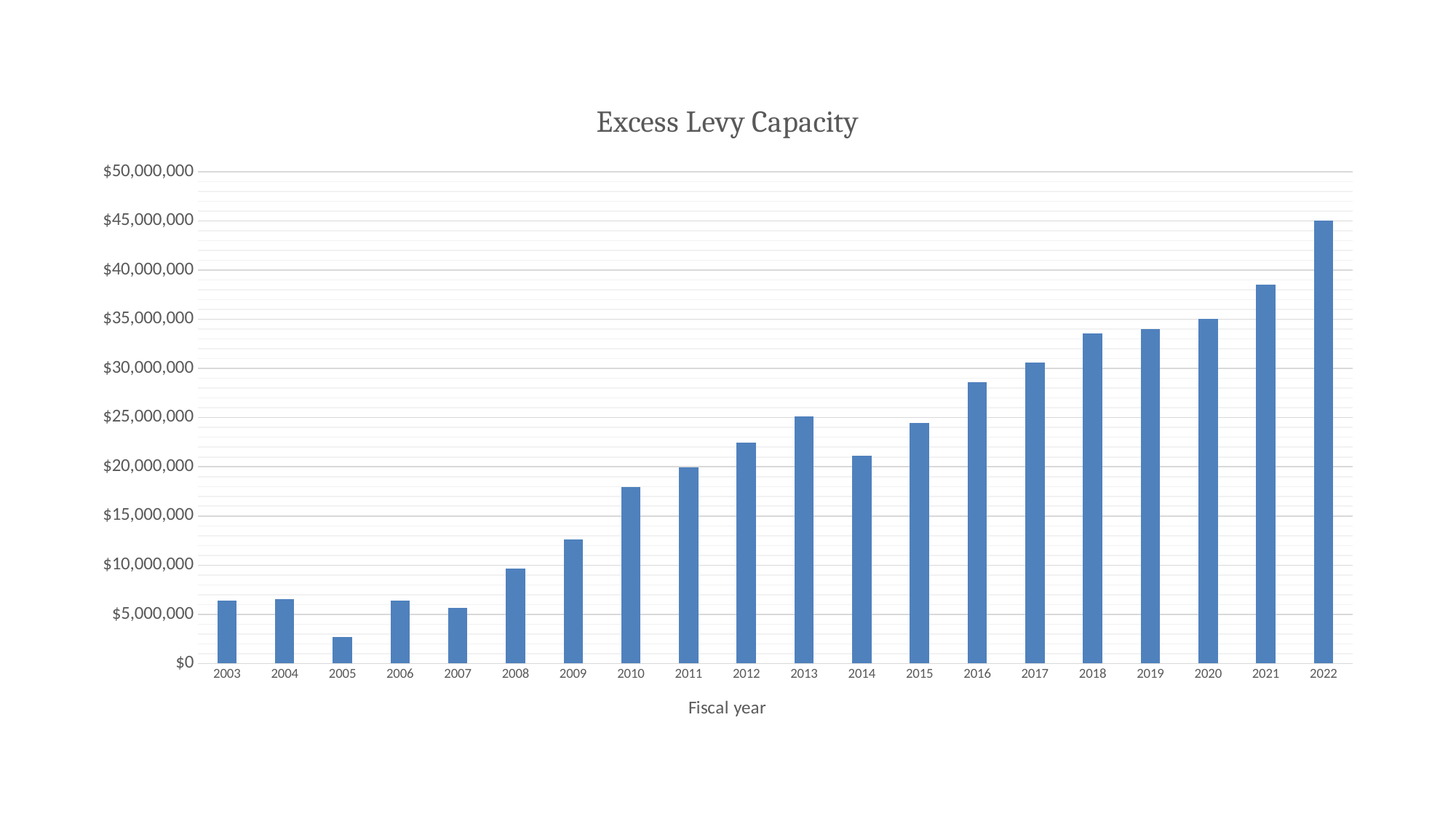
What type of chart is shown on the slide? bar chart How many fiscal years are plotted on the chart? 20 Is the value for 2010 greater or less than $20,000,000? less Overall, do the values rise or fall from 2003 to 2022? rise Is the value for 2022 greater or less than $40,000,000? greater Which is larger, the value for 2020 or the value for 2021? 2021 What is the title of the chart? Excess Levy Capacity Which fiscal year has the highest excess levy capacity? 2022 Which is larger, the value for 2013 or the value for 2014? 2013 Is the value for 2016 greater or less than $25,000,000? greater Which fiscal year has the lowest excess levy capacity? 2005